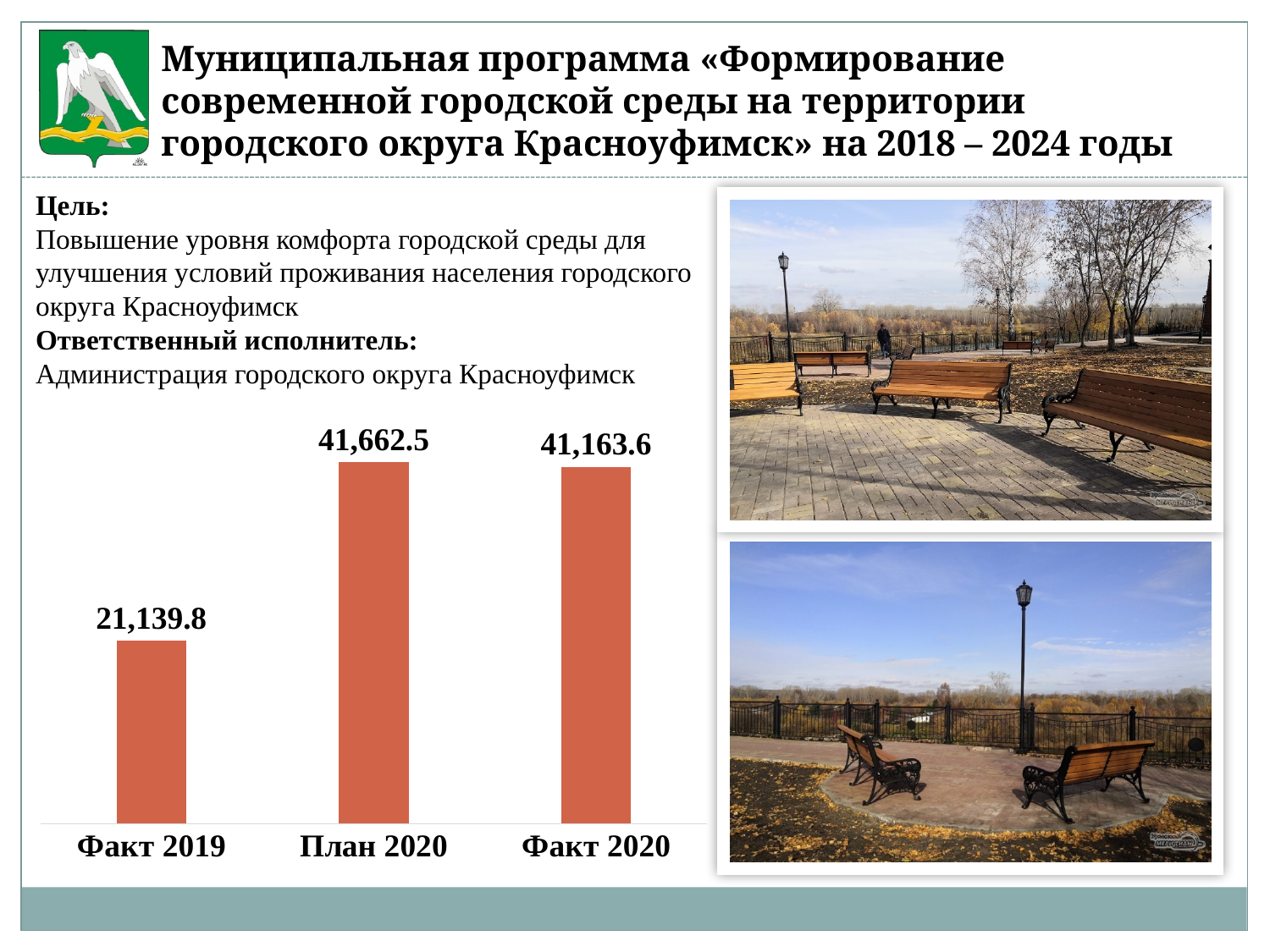
What is the value shown for План 2020? 41,662.5 What kind of chart is shown on the slide? Bar chart What is the difference between the values for Факт 2020 and Факт 2019? 20,023.8 What is the value shown for Факт 2019? 21,139.8 Which is larger, the value for План 2020 or the value for Факт 2020? План 2020 What is the difference between the values for План 2020 and Факт 2020? 498.9 Which category has the lowest value? Факт 2019 How many categories are shown in the chart? 3 Which category has the highest value? План 2020 Which is larger, the value for Факт 2019 or the value for Факт 2020? Факт 2020 What is the value shown for Факт 2020? 41,163.6 What is the difference between the values for План 2020 and Факт 2019? 20,522.7